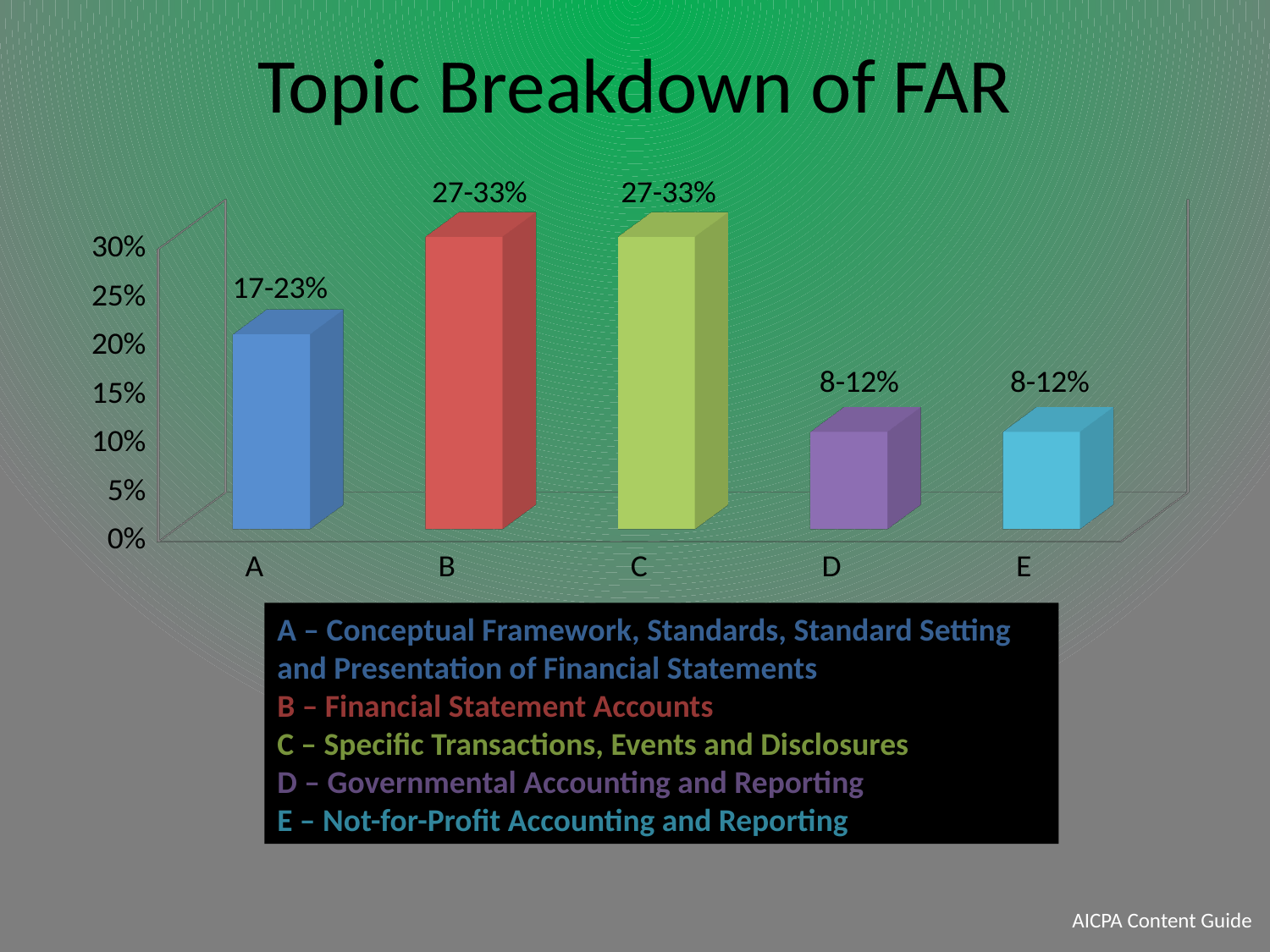
How many categories are plotted on the chart? 5 Is the bar for category A greater or less than 15%? greater Which is larger, the value for A or the value for D? A What value is labelled on the bar for category A? 17-23% Which is larger, the value for A or the value for B? B What value is labelled on the bar for category B? 27-33% What value is labelled on the bar for category E? 8-12% What is the title of the chart? Topic Breakdown of FAR What value is labelled on the bar for category C? 27-33% What value is labelled on the bar for category D? 8-12% Is the bar for category E greater or less than 15%? less What kind of chart is shown on the slide? Bar chart